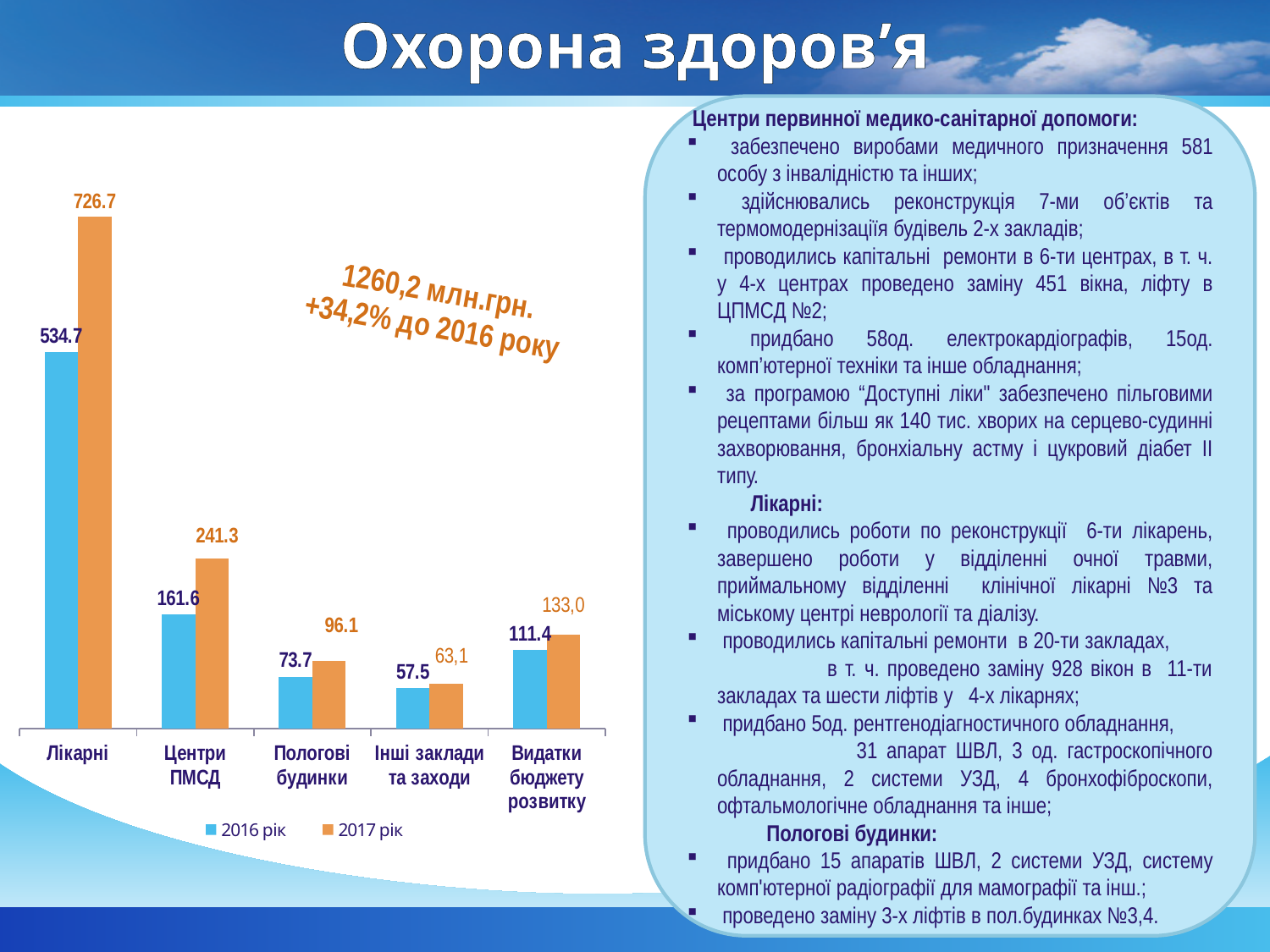
What kind of chart is shown on the slide? Bar chart Which is larger: the 2017 рік value for Пологові будинки or the 2016 рік value for Видатки бюджету розвитку? 2016 рік value for Видатки бюджету розвитку What is the 2016 рік value for Центри ПМСД? 161.6 Which series is shown in orange in the chart? 2017 рік What is the 2017 рік value for Інші заклади та заходи? 63,1 Which category has the lowest 2016 рік value? Інші заклади та заходи What is the difference between the 2017 рік and 2016 рік values for Лікарні? 192.0 Which category has the highest 2017 рік value? Лікарні What is the 2017 рік value for Лікарні? 726.7 How many series does the chart legend list? 2 What is the 2016 рік value for Видатки бюджету розвитку? 111.4 How many categories are shown on the x axis of the chart? 5